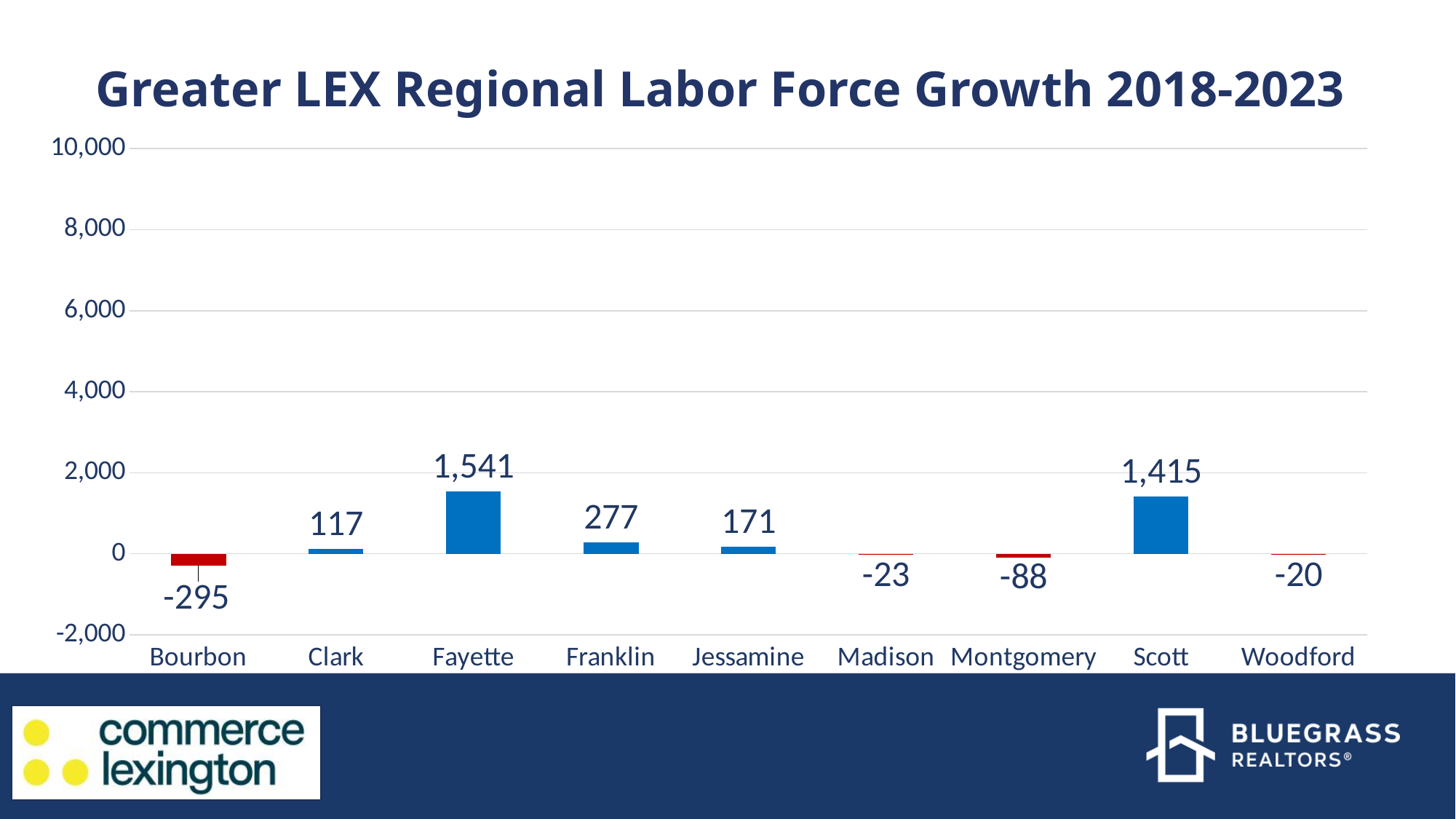
What colour are the bars for counties with negative values? Red What is the labor force growth value for Montgomery? -88 What is the labor force growth value for Scott? 1,415 What is the difference between the values for Fayette and Scott? 126 What kind of chart is shown on the slide? Bar chart Which has a larger labor force growth value, Franklin or Jessamine? Franklin Which county has the highest labor force growth? Fayette What is the labor force growth value for Bourbon? -295 What is the labor force growth value for Fayette? 1,541 What is the title of the chart? Greater LEX Regional Labor Force Growth 2018-2023 Which county has the lowest labor force growth? Bourbon How many counties are shown on the x axis? 9